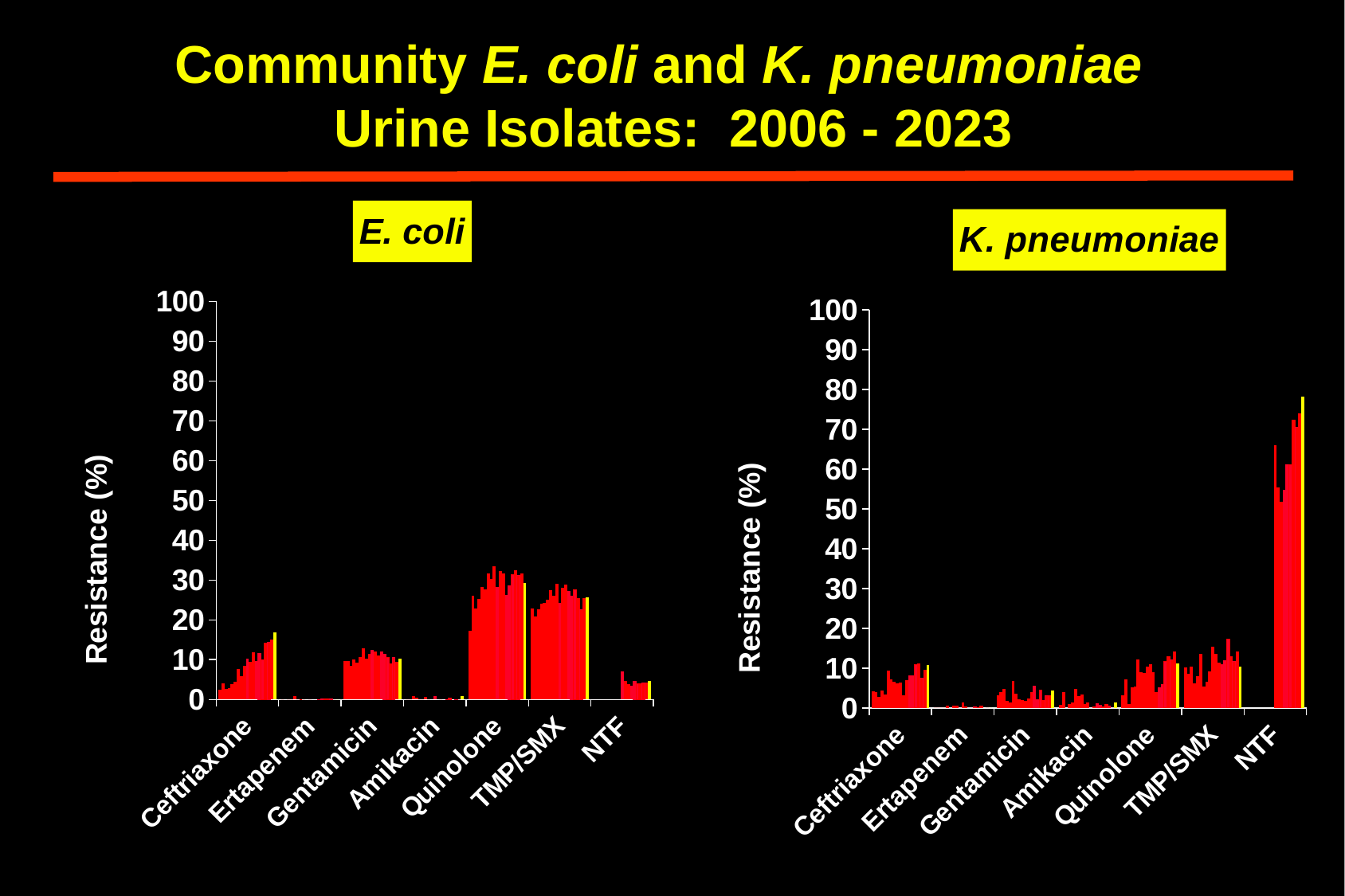
What range of years does the slide title say the urine isolates cover? 2006 - 2023 In the K. pneumoniae chart, are the NTF resistance values greater or less than 50? greater In the E. coli chart, which has higher resistance values, Quinolone or Amikacin? Quinolone In the K. pneumoniae chart, which has higher resistance values, NTF or Ertapenem? NTF In the K. pneumoniae chart, are the Ceftriaxone resistance values greater or less than 20? less In the E. coli chart, which antibiotic category shows the highest resistance values? Quinolone What is the y-axis label on the E. coli chart? Resistance (%) In the E. coli chart, are the Ertapenem resistance values greater or less than 10? less In the K. pneumoniae chart, which antibiotic category shows the highest resistance values? NTF What kind of chart is the E. coli chart on the left? Bar chart How many antibiotic categories are shown on the x axis of the K. pneumoniae chart? 7